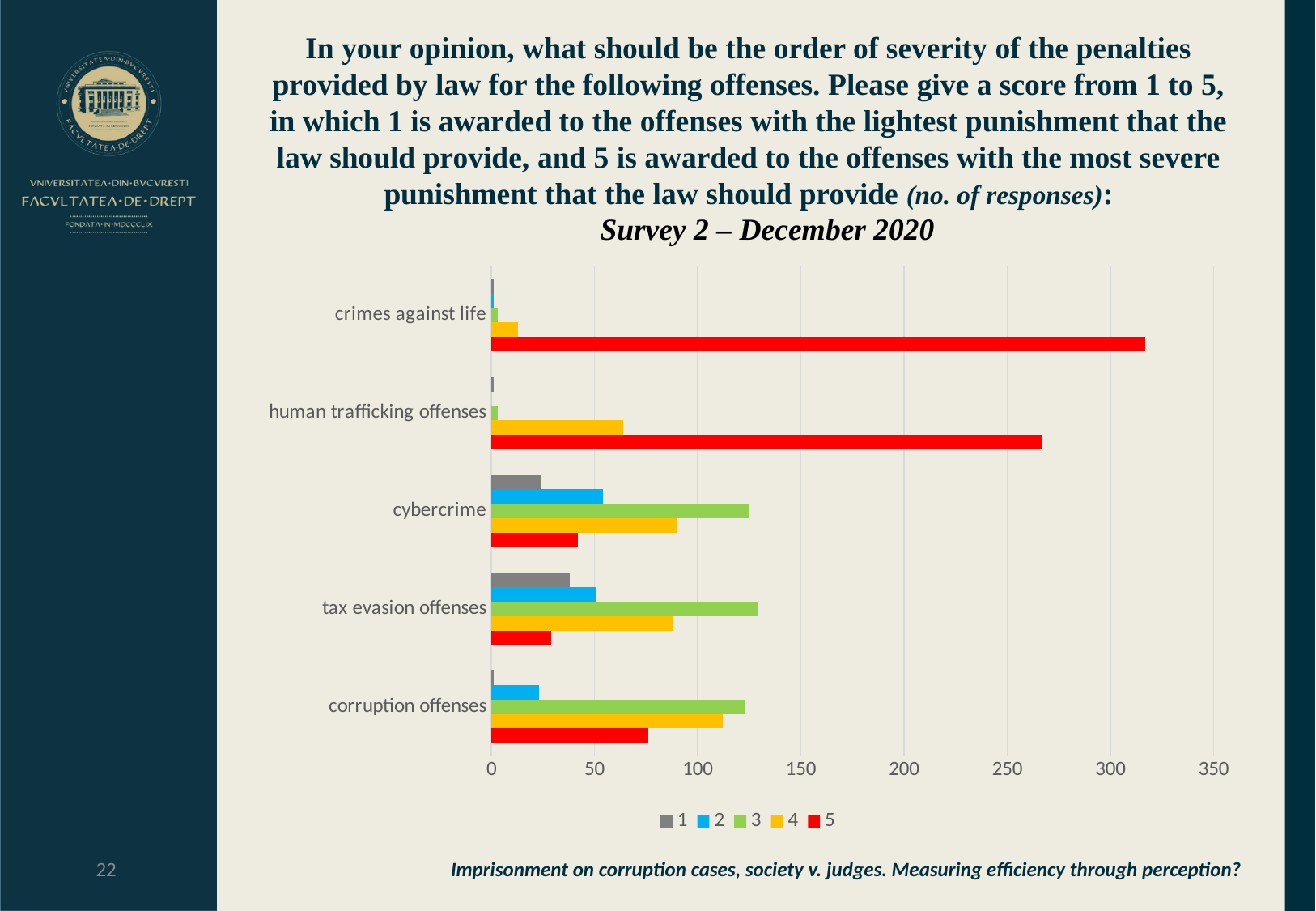
Is the score-5 value for human trafficking offenses greater or less than 250? greater Which offense category has the shortest bar for score 5? tax evasion offenses For corruption offenses, which is larger: the score-3 value or the score-5 value? score 3 Is the score-5 value for tax evasion offenses greater or less than 50? less Which has the larger score-5 value: crimes against life or human trafficking offenses? crimes against life Which offense category has the longest bar for score 5? crimes against life What kind of chart is shown on the slide? bar chart Is the score-5 value for crimes against life greater or less than 300? greater What colour represents score 5 in the legend? red How many offense categories are plotted on the chart? 5 How many series does the legend list? 5